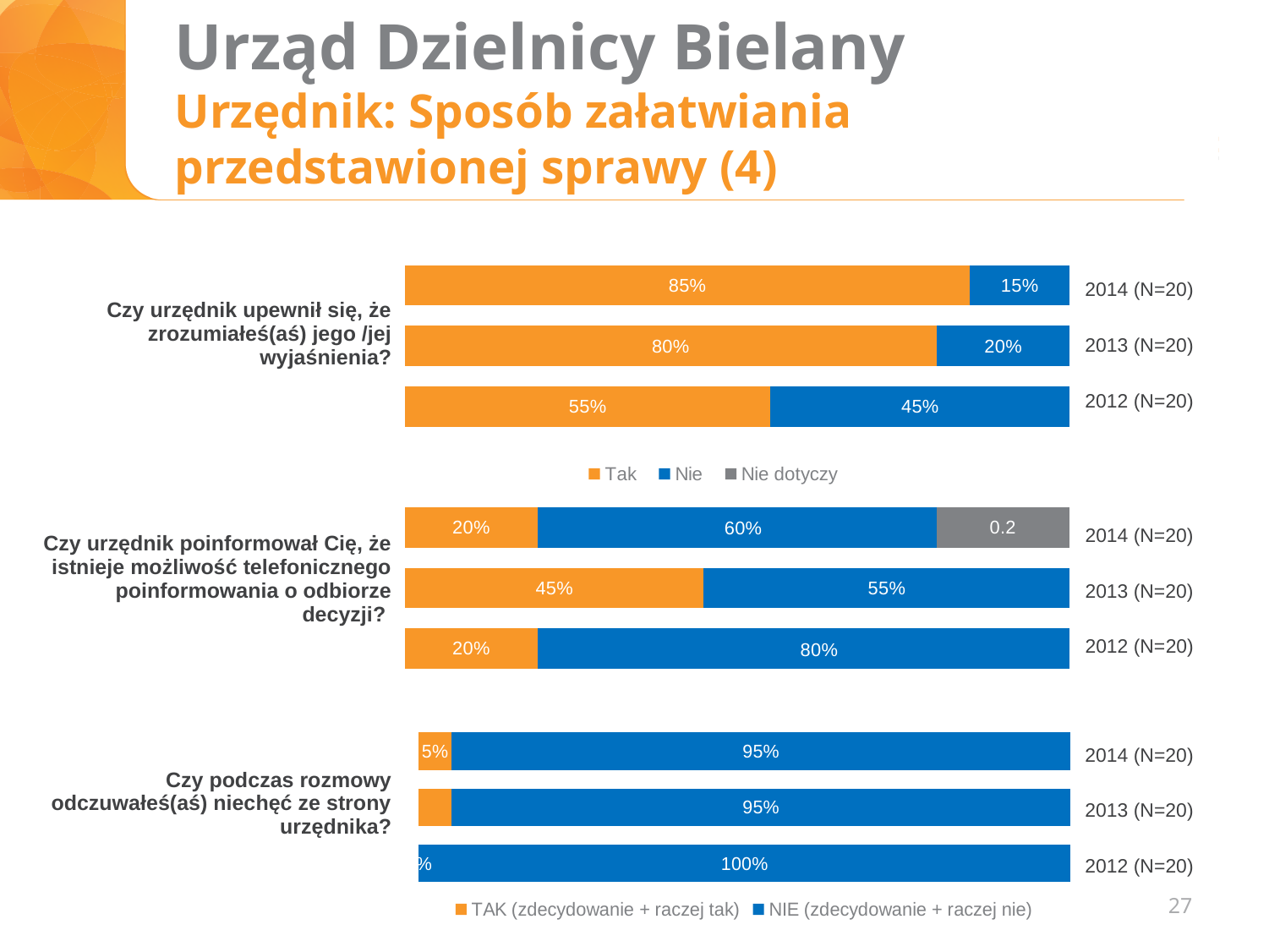
In the middle chart ("Czy urzędnik poinformował Cię, że istnieje możliwość telefonicznego poinformowania o odbiorze decyzji?"), how many series does the legend list? 3 In the bottom chart ("Czy podczas rozmowy odczuwałeś(aś) niechęć ze strony urzędnika?"), is the "NIE" value for 2014 larger or the "TAK" value for 2014? NIE In the top chart ("Czy urzędnik upewnił się, że zrozumiałeś(aś) jego /jej wyjaśnienia?"), what is the "Nie" value for 2012 (N=20)? 45% In the bottom chart ("Czy podczas rozmowy odczuwałeś(aś) niechęć ze strony urzędnika?"), what is the "NIE (zdecydowanie + raczej nie)" value for 2012 (N=20)? 100% In the top chart ("Czy urzędnik upewnił się, że zrozumiałeś(aś) jego /jej wyjaśnienia?"), which year has the highest "Tak" value? 2014 (N=20) In the top chart ("Czy urzędnik upewnił się, że zrozumiałeś(aś) jego /jej wyjaśnienia?"), what is the "Tak" value for 2014 (N=20)? 85% In the top chart ("Czy urzędnik upewnił się, że zrozumiałeś(aś) jego /jej wyjaśnienia?"), what is the difference between the "Tak" values for 2014 and 2012? 30% In the middle chart ("Czy urzędnik poinformował Cię, że istnieje możliwość telefonicznego poinformowania o odbiorze decyzji?"), what is the "Nie" value for 2014 (N=20)? 60% In the middle chart ("Czy urzędnik poinformował Cię, że istnieje możliwość telefonicznego poinformowania o odbiorze decyzji?"), which year has the lowest "Nie" value? 2013 (N=20) In the middle chart ("Czy urzędnik poinformował Cię, że istnieje możliwość telefonicznego poinformowania o odbiorze decyzji?"), what is the "Tak" value for 2013 (N=20)? 45% In the top chart ("Czy urzędnik upewnił się, że zrozumiałeś(aś) jego /jej wyjaśnienia?"), how many years (bars) are shown? 3 What kind of chart is the top chart ("Czy urzędnik upewnił się, że zrozumiałeś(aś) jego /jej wyjaśnienia?")? Stacked bar chart